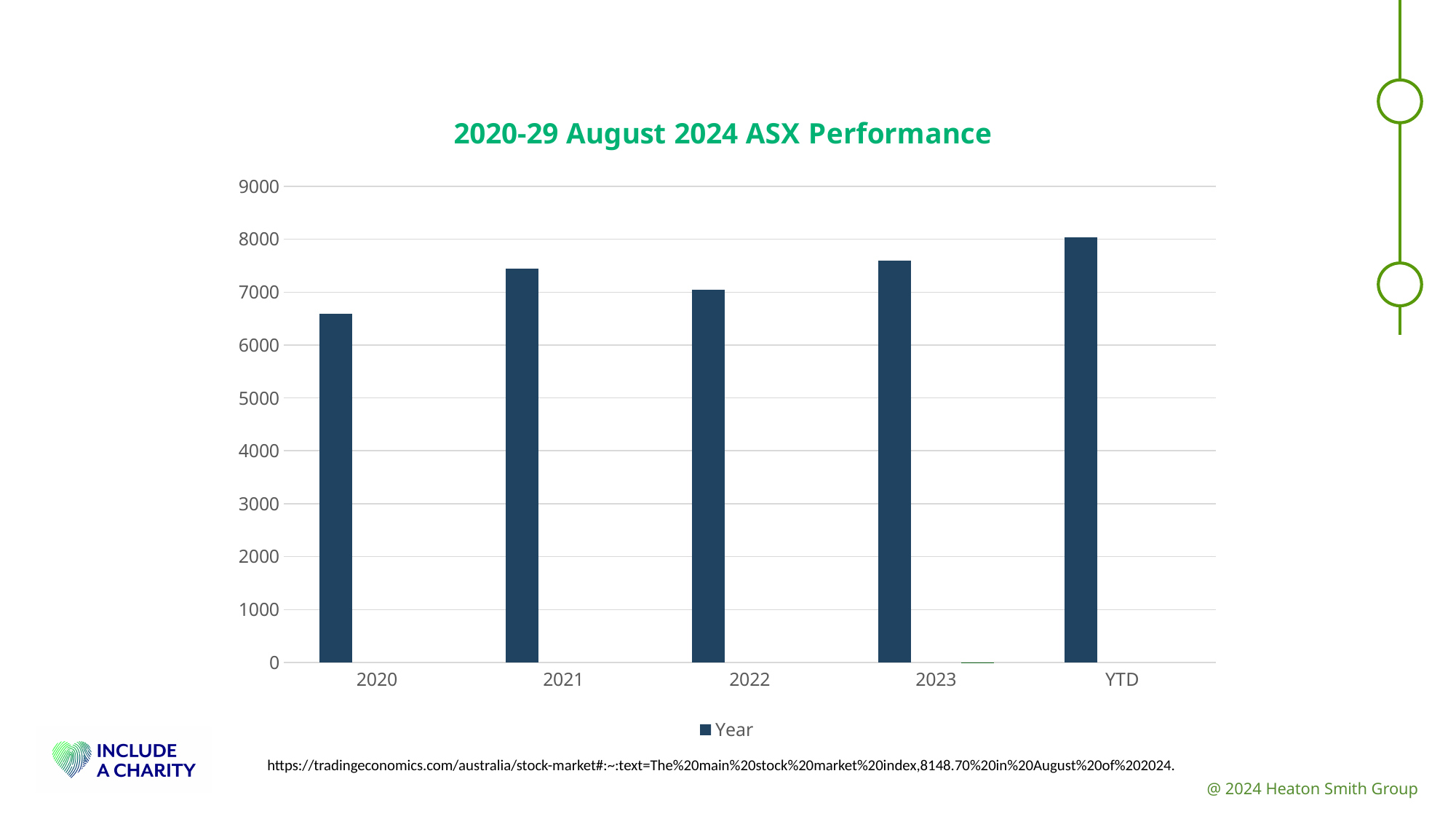
Does the value rise or fall from 2021 to 2022? fall How many categories are shown on the x axis of the chart? 5 How many series does the chart's legend list? 1 What is the title of the chart? 2020-29 August 2024 ASX Performance Which is larger, the value for 2021 or the value for 2022? 2021 Is the value for 2023 greater or less than 8000? less What type of chart is shown on the slide? Bar chart Is the value for 2020 greater or less than 7000? less Which category has the lowest bar in the chart? 2020 Which category has the highest bar in the chart? YTD